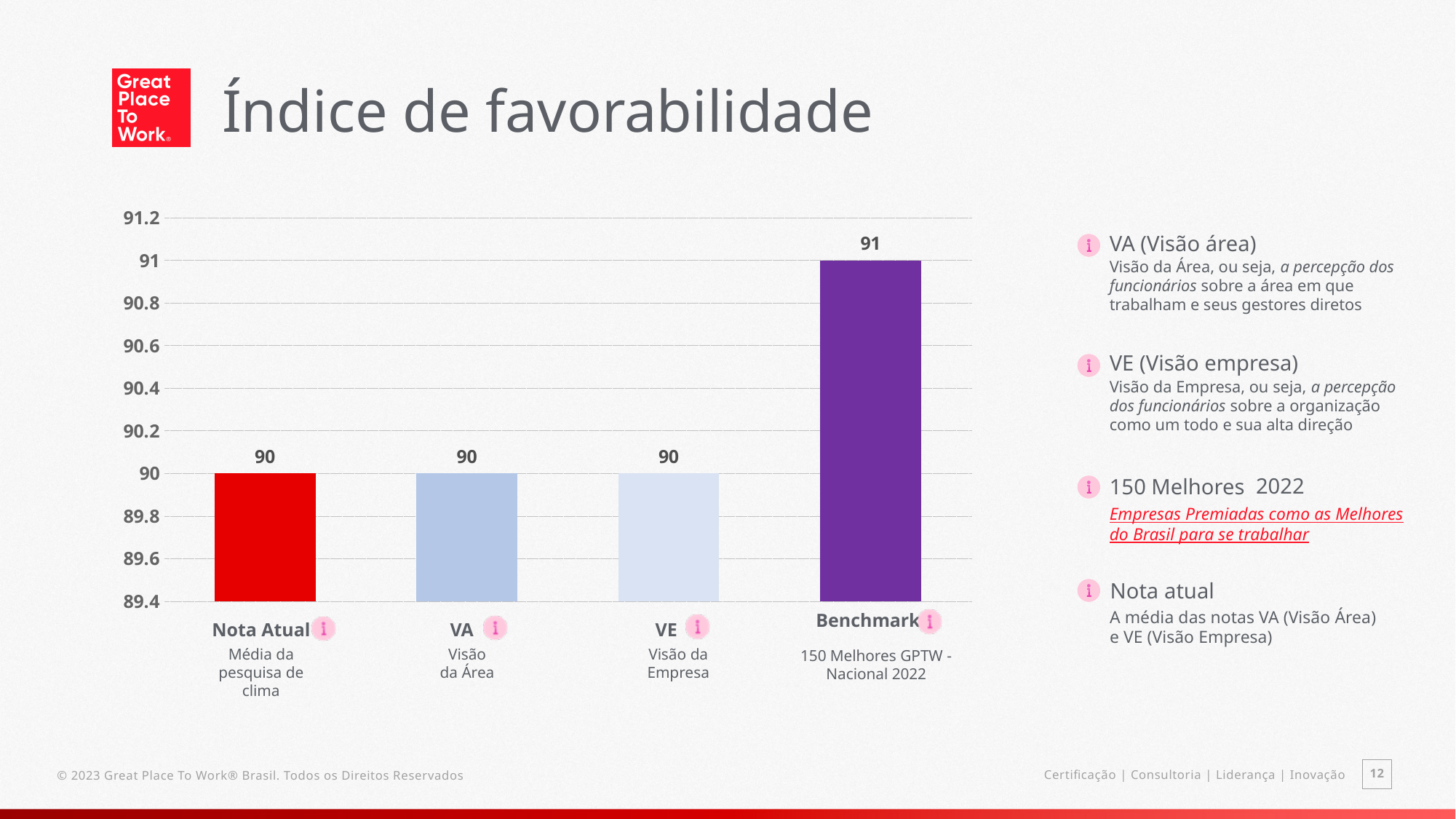
What kind of chart is shown on the slide? bar chart Which category has the highest value? Benchmark What is the value for VA? 90 What is the difference between the Benchmark value and the Nota Atual value? 1 What colour is the Nota Atual bar? red What is the title of the slide containing the chart? Índice de favorabilidade Which is larger, the value for Benchmark or the value for VE? Benchmark What is the value for VE? 90 How many categories are shown in the chart? 4 What is the value for Nota Atual? 90 Is the value for Benchmark greater or less than 90.6? greater What is the value for Benchmark? 91